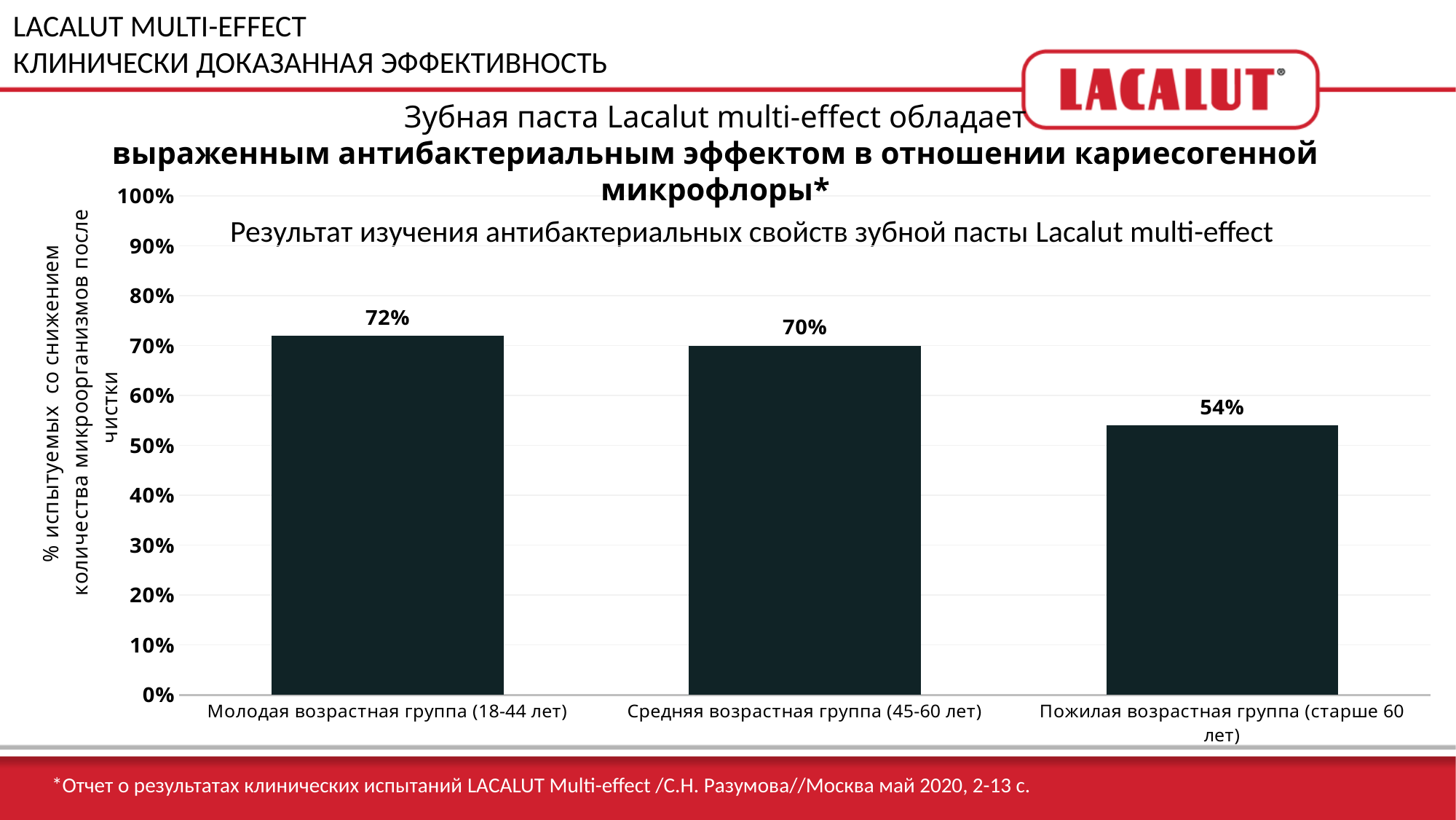
Is the value for the elderly age group (over 60 years) greater or less than 60%? less What kind of chart is shown on the slide? bar chart What is the value for the young age group (18-44 years)? 72% How many age groups are shown in the chart? 3 Do the values rise or fall from the young age group to the elderly age group? fall Which is larger, the value for the middle age group (45-60 years) or the elderly age group (over 60 years)? Средняя возрастная группа (45-60 лет) What is the value for the elderly age group (over 60 years)? 54% Which age group has the lowest value? Пожилая возрастная группа (старше 60 лет) What is the value for the middle age group (45-60 years)? 70% What is the difference between the values for the middle age group and the elderly age group? 16% What is the difference between the values for the young age group and the elderly age group? 18% Which age group has the highest value? Молодая возрастная группа (18-44 лет)